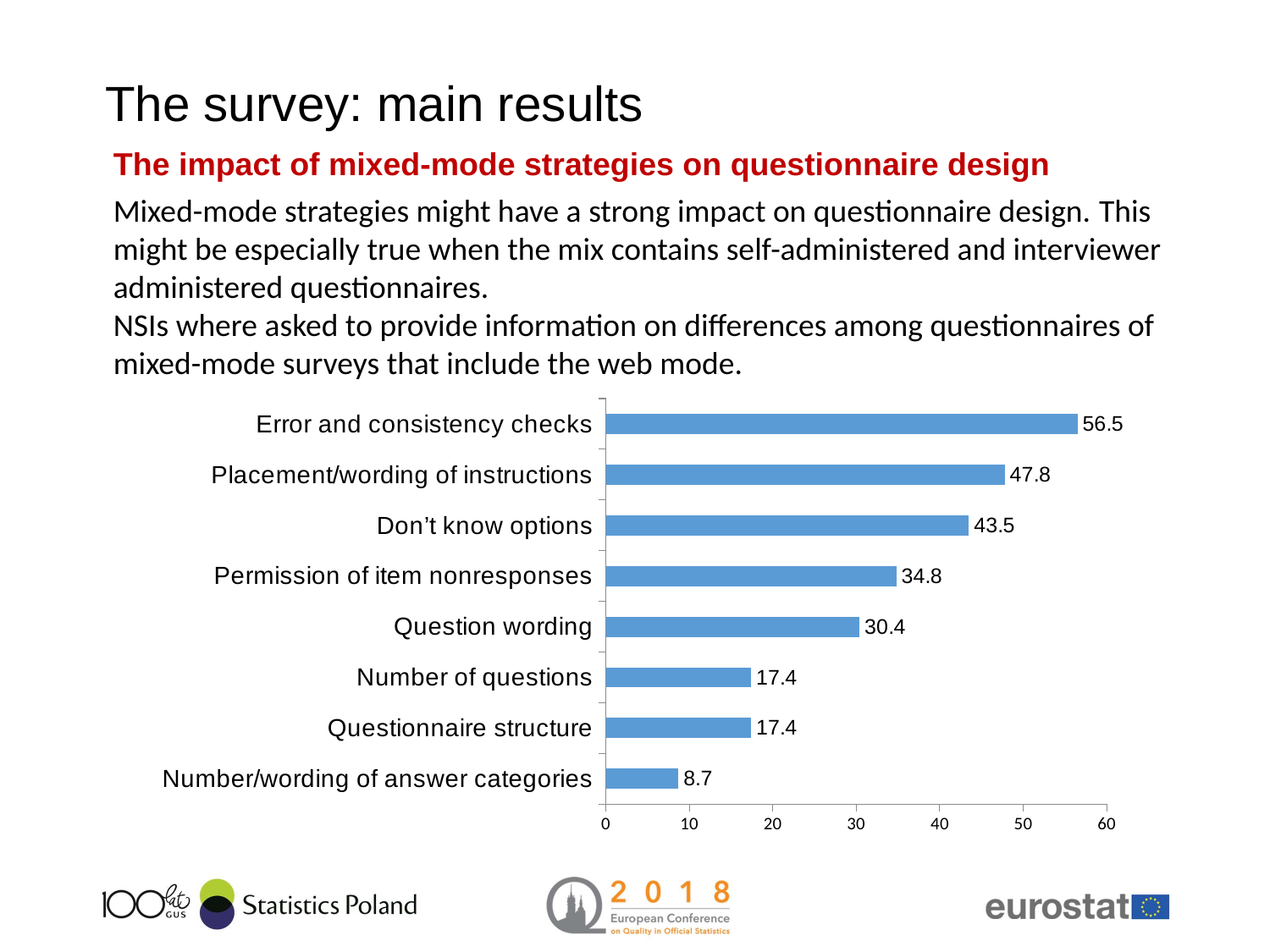
Which two categories share the same value of 17.4? Number of questions and Questionnaire structure What is the value for Error and consistency checks? 56.5 What is the difference between the values for Error and consistency checks and Number/wording of answer categories? 47.8 Which category has the highest value? Error and consistency checks Which is larger, the value for Don't know options or the value for Question wording? Don't know options Which category has the lowest value? Number/wording of answer categories What is the value for Don't know options? 43.5 What kind of chart is shown on the slide? Bar chart How many categories are shown in the chart? 8 What is the difference between the values for Placement/wording of instructions and Permission of item nonresponses? 13.0 What is the value for Question wording? 30.4 What is the value for Number/wording of answer categories? 8.7